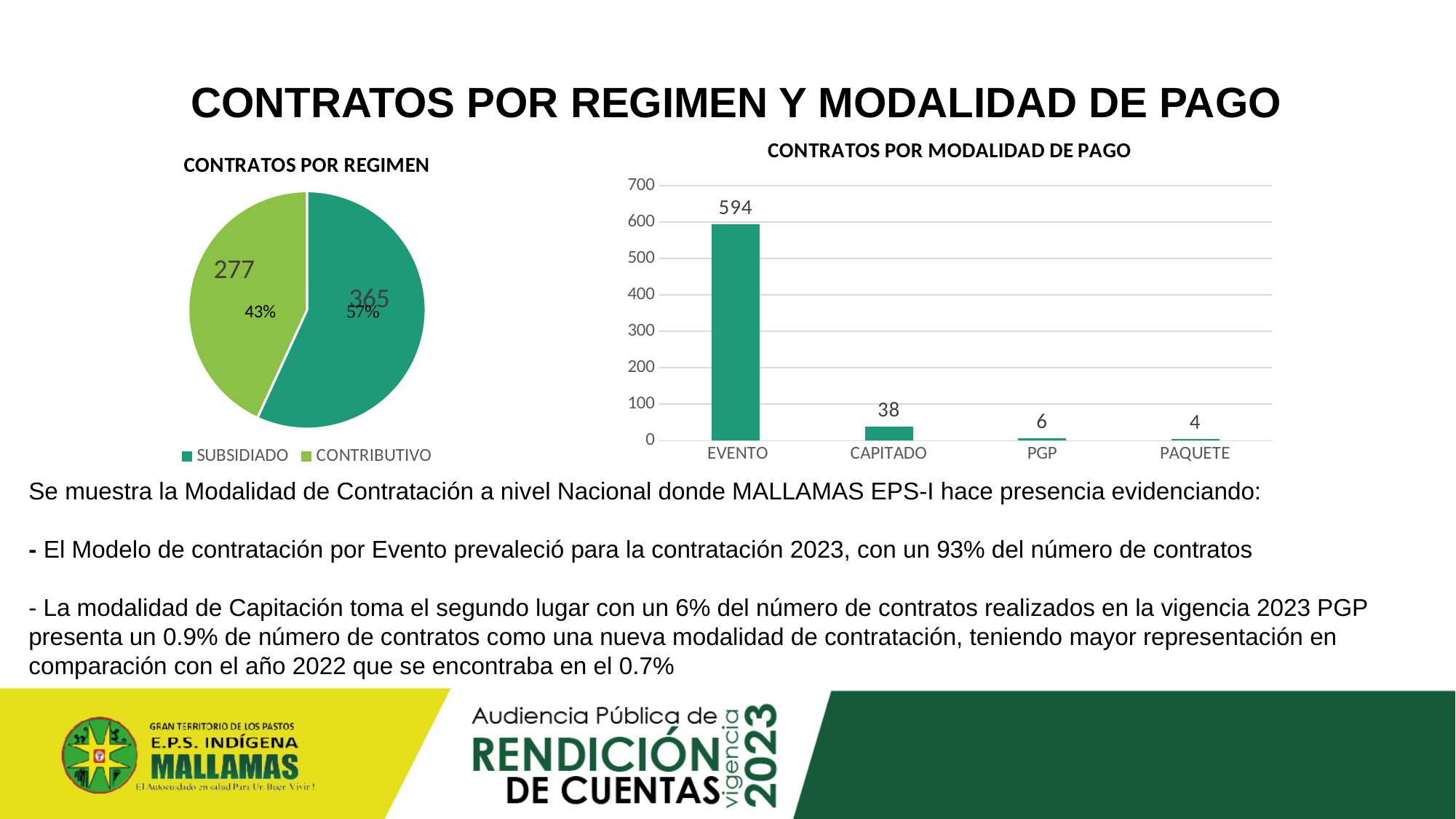
What kind of chart is CONTRATOS POR MODALIDAD DE PAGO? Bar chart In the CONTRATOS POR REGIMEN chart, what share of the pie does CONTRIBUTIVO represent? 43% In the CONTRATOS POR MODALIDAD DE PAGO chart, how many categories are shown on the x axis? 4 In the CONTRATOS POR MODALIDAD DE PAGO chart, what is the value for EVENTO? 594 In the CONTRATOS POR REGIMEN chart, what is the value for CONTRIBUTIVO? 277 In the CONTRATOS POR MODALIDAD DE PAGO chart, what is the value for CAPITADO? 38 In the CONTRATOS POR REGIMEN chart, what is the difference between SUBSIDIADO and CONTRIBUTIVO? 88 In the CONTRATOS POR MODALIDAD DE PAGO chart, which category has the lowest value? PAQUETE In the CONTRATOS POR MODALIDAD DE PAGO chart, what is the difference between EVENTO and CAPITADO? 556 In the CONTRATOS POR REGIMEN chart, what is the value for SUBSIDIADO? 365 In the CONTRATOS POR REGIMEN chart, what share of the pie does SUBSIDIADO represent? 57% What kind of chart is CONTRATOS POR REGIMEN? Pie chart